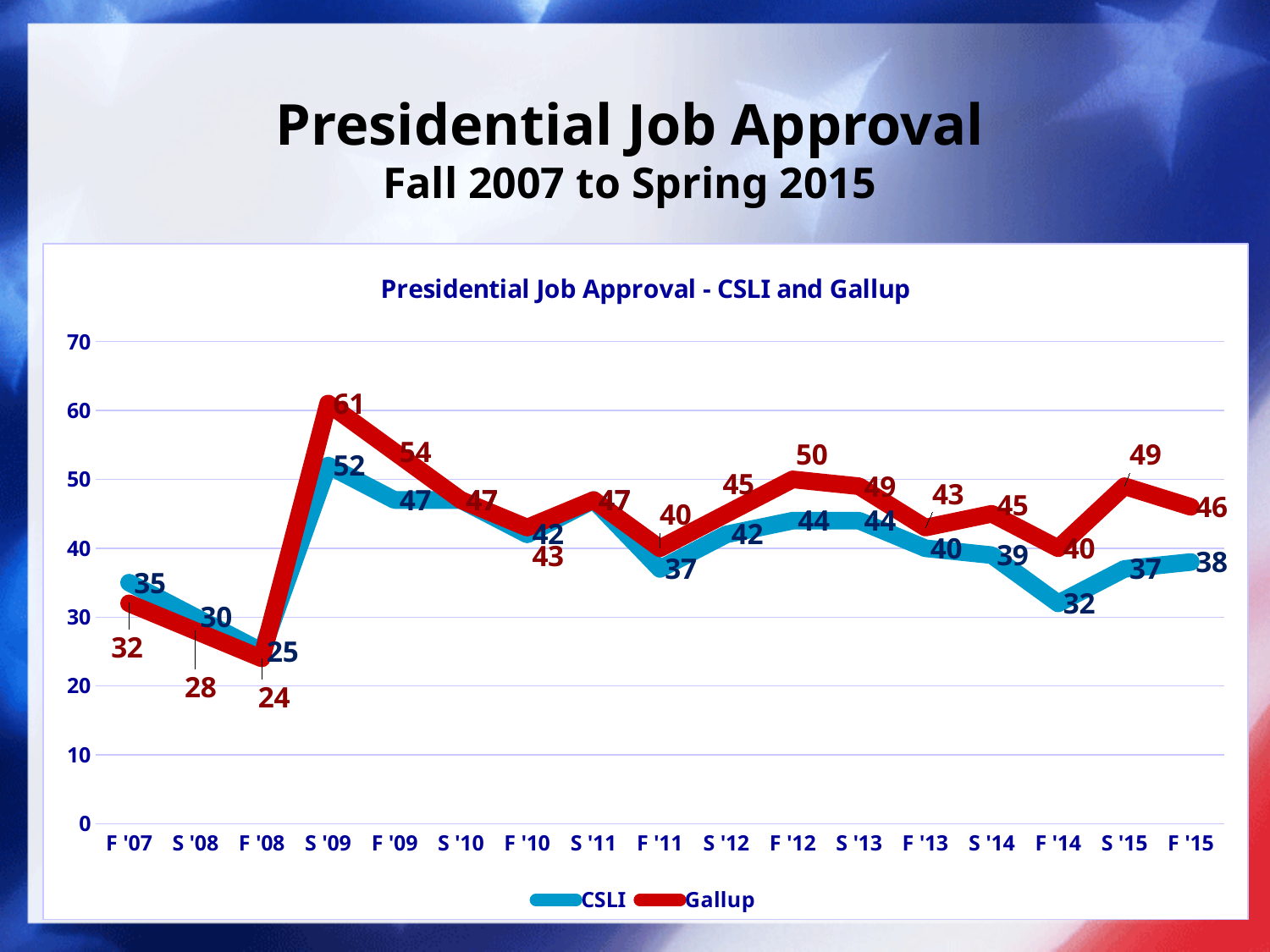
What colour is the Gallup line in the legend? red Does the CSLI series rise or fall from F '07 to F '08? fall At which time point is the Gallup series highest? S '09 At S '15, which series has the larger value, CSLI or Gallup? Gallup What is the difference between the Gallup and CSLI values at F '12? 6 What is the Gallup value for S '09? 61 At which time point is the CSLI series lowest? F '08 What is the CSLI value for F '15? 38 What kind of chart is shown on the slide? line chart What is the CSLI value for F '14? 32 How many time points are plotted along the x axis? 17 How many series does the legend list? 2